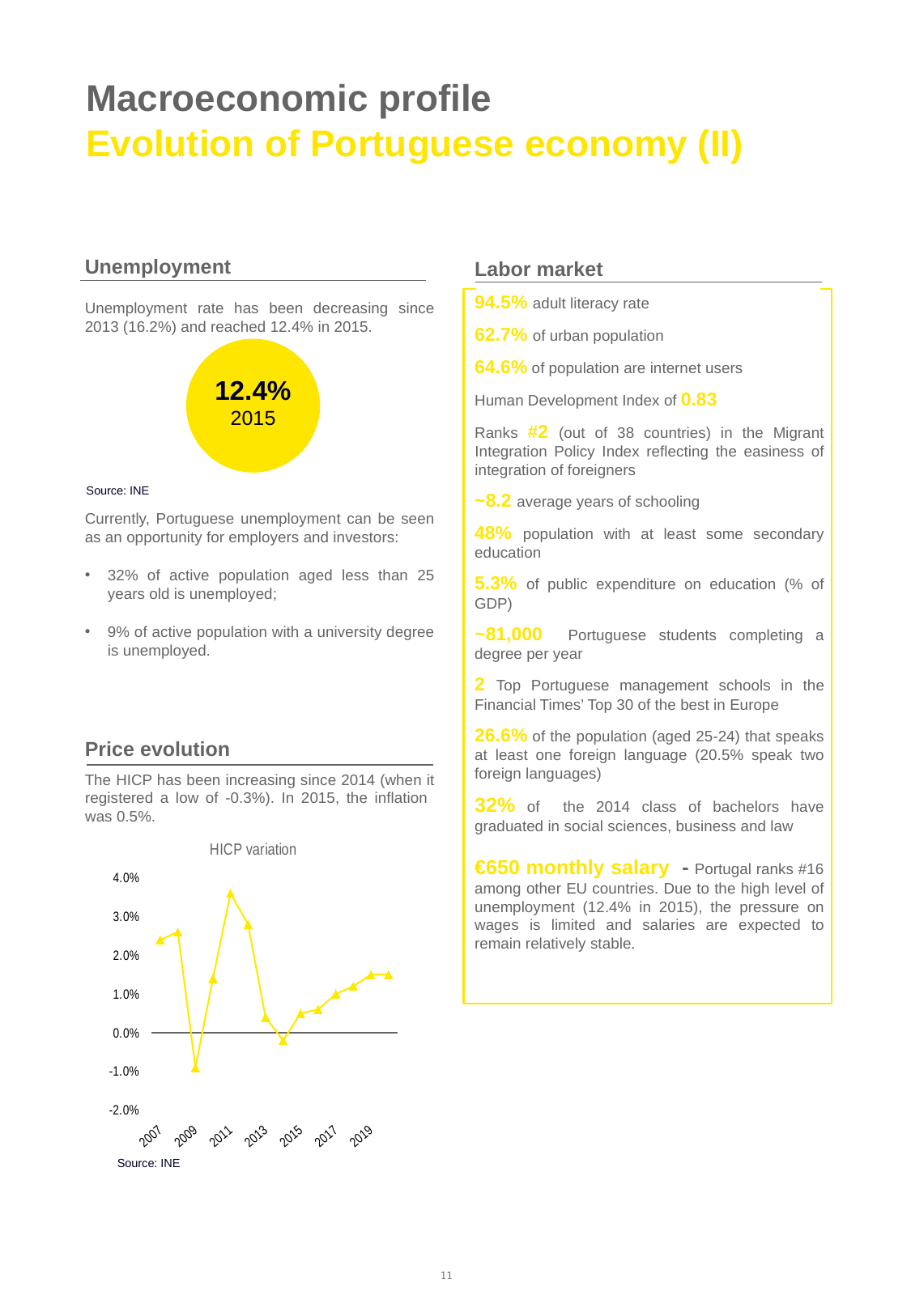
In the HICP variation chart, which year shows the highest value? 2011 In the HICP variation chart, which year has the larger value, 2007 or 2013? 2007 In the HICP variation chart, is the value for 2009 greater or less than 0.0%? less In the HICP variation chart, is the value for 2011 greater or less than 3.0%? greater In the HICP variation chart, is the value for 2007 greater or less than 2.0%? greater How many year labels are shown on the x axis of the HICP variation chart? 7 In the HICP variation chart, do the values rise or fall from 2015 to 2019? rise What kind of chart is the HICP variation chart? line chart In the HICP variation chart, which year shows the lowest value? 2009 What is the title of the chart in the Price evolution section? HICP variation